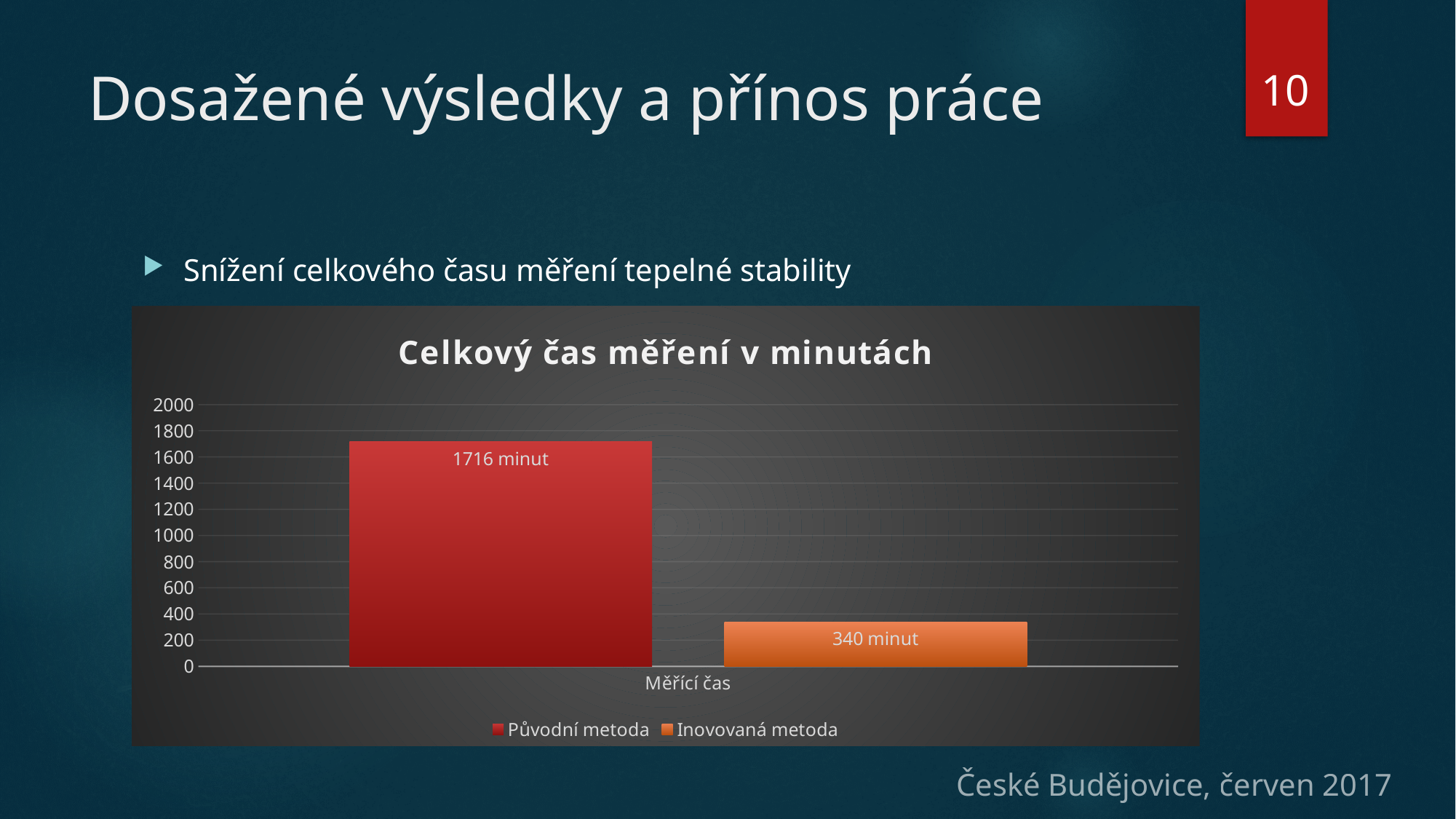
How many series does the legend list? 2 What is the value for Inovovaná metoda? 340 minut Which is larger, Původní metoda or Inovovaná metoda? Původní metoda What is the difference between Původní metoda and Inovovaná metoda? 1376 minut What is the title of the chart? Celkový čas měření v minutách What is the category label on the x axis? Měřící čas Which series has the highest value? Původní metoda Is the value for Inovovaná metoda greater or less than 400? less What is the value for Původní metoda? 1716 minut Is the value for Původní metoda greater or less than 1600? greater What kind of chart is shown? bar chart Which series has the lowest value? Inovovaná metoda